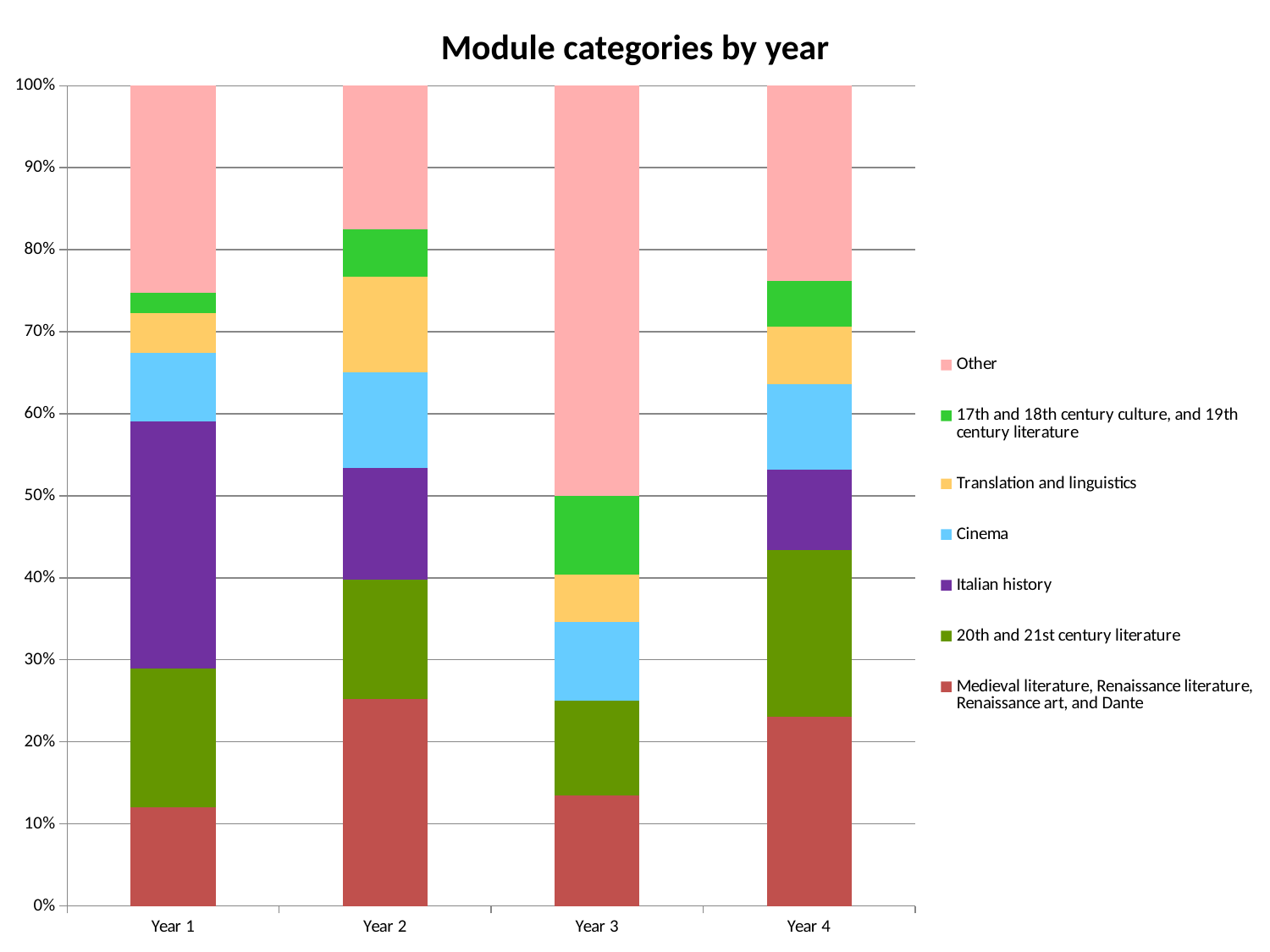
Which is larger: the 20th and 21st century literature share in Year 3 or in Year 4? Year 4 Which year has the largest share for Other? Year 3 Which year has the largest share for Italian history? Year 1 Which is larger: the Medieval literature, Renaissance literature, Renaissance art, and Dante share in Year 1 or in Year 2? Year 2 Is the share for Other in Year 3 greater or less than 40%? greater What is the title of the chart? Module categories by year Is the share for Medieval literature, Renaissance literature, Renaissance art, and Dante in Year 2 greater or less than 20%? greater How many years (categories) are shown on the x axis? 4 Which year has no Italian history segment in its bar? Year 3 What kind of chart is shown on the slide? Stacked bar chart What is the total height of the Year 1 stacked bar? 100% How many series does the legend list? 7